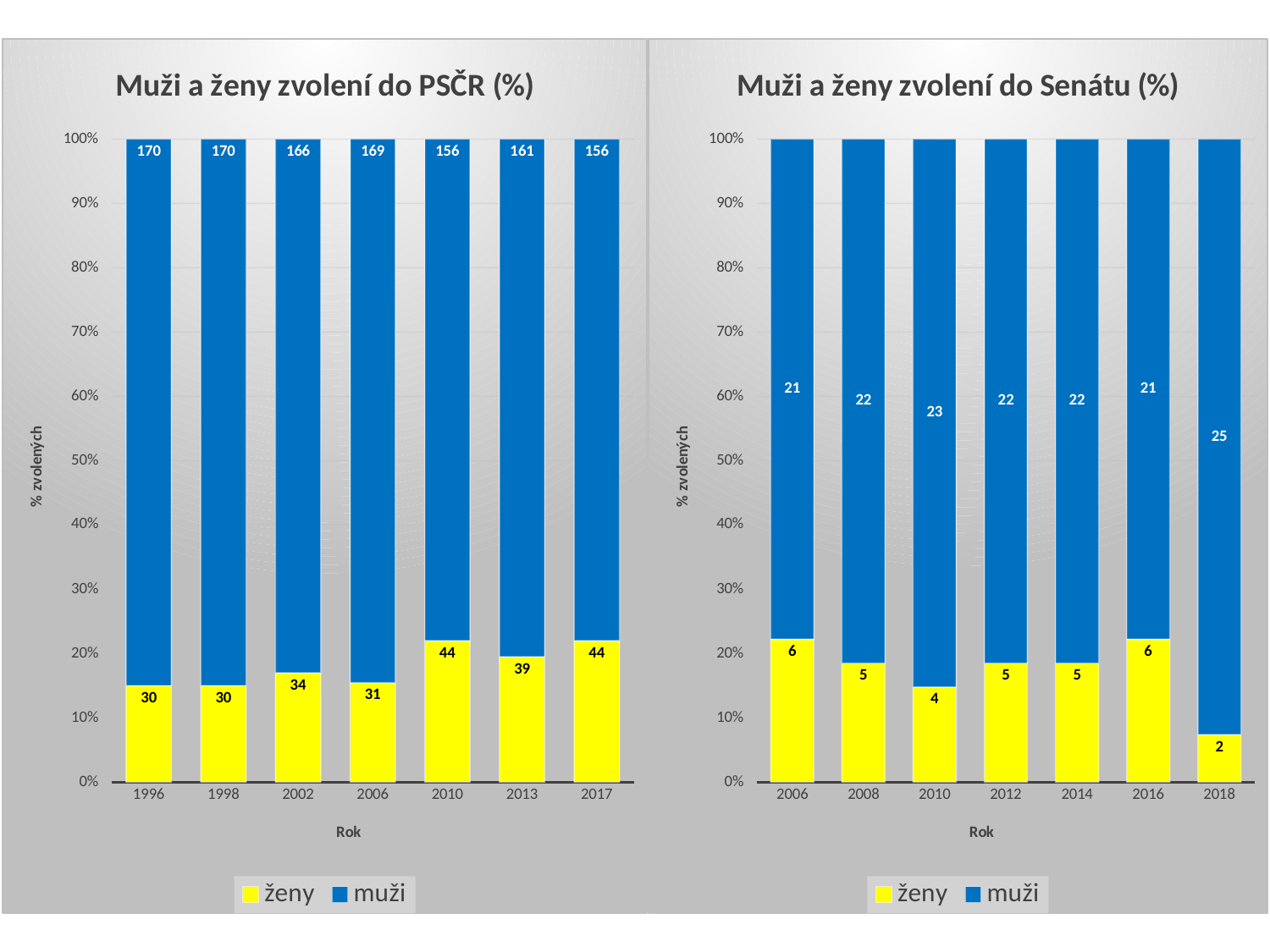
In the chart titled "Muži a ženy zvolení do Senátu (%)", what is the data label for muži in 2018? 25 In the chart titled "Muži a ženy zvolení do Senátu (%)", is the ženy label larger in 2006 or in 2010? 2006 In the chart titled "Muži a ženy zvolení do Senátu (%)", which year has the lowest data label for ženy? 2018 What kind of chart is the chart titled "Muži a ženy zvolení do Senátu (%)"? stacked bar chart In the chart titled "Muži a ženy zvolení do PSČR (%)", which year has the lowest data label for ženy? 1996 and 1998 (both 30) In the chart titled "Muži a ženy zvolení do PSČR (%)", what is the difference between the muži labels for 1996 and 2017? 14 In the chart titled "Muži a ženy zvolení do PSČR (%)", what is the data label for muži in 2002? 166 In the chart titled "Muži a ženy zvolení do PSČR (%)", how many years are shown on the x axis? 7 In the chart titled "Muži a ženy zvolení do PSČR (%)", what is the data label for ženy in 2010? 44 In the chart titled "Muži a ženy zvolení do Senátu (%)", which year has the highest data label for muži? 2018 In the chart titled "Muži a ženy zvolení do Senátu (%)", how many series does the legend list? 2 In the chart titled "Muži a ženy zvolení do PSČR (%)", is the ženy share in 2010 greater or less than 20%? greater